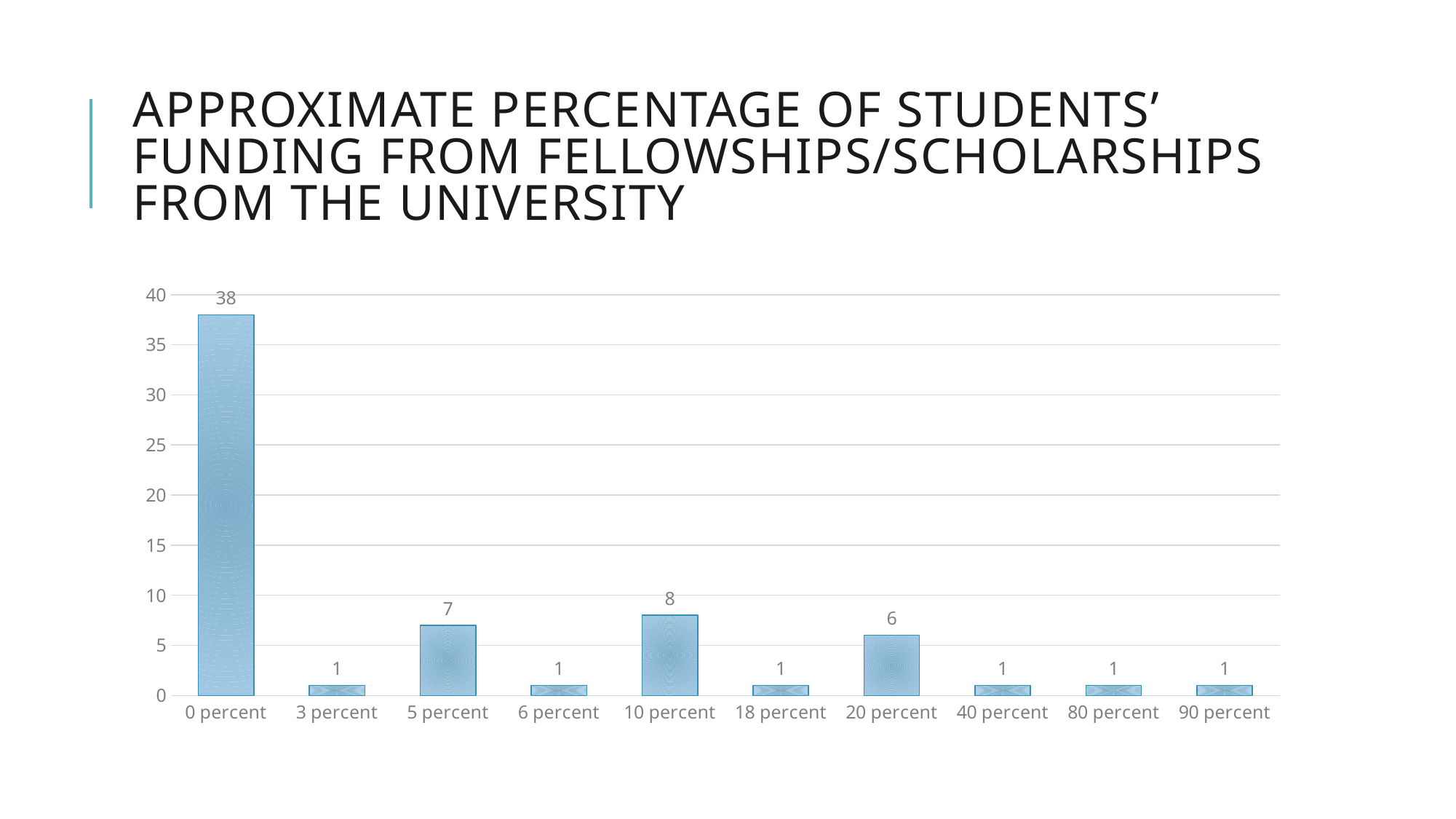
What is the value for the 20 percent category? 6 What is the value for the 5 percent category? 7 Is the value for 0 percent greater or less than 35? greater What is the value for the 0 percent category? 38 What is the difference between the values for 5 percent and 20 percent? 1 What kind of chart is shown on the slide? bar chart How many categories are shown on the x axis? 10 What is the title of the chart on the slide? Approximate percentage of students' funding from fellowships/scholarships from the university What is the difference between the values for 0 percent and 10 percent? 30 Which category has the highest value? 0 percent Which is larger, the value for 10 percent or the value for 5 percent? 10 percent What is the value for the 10 percent category? 8